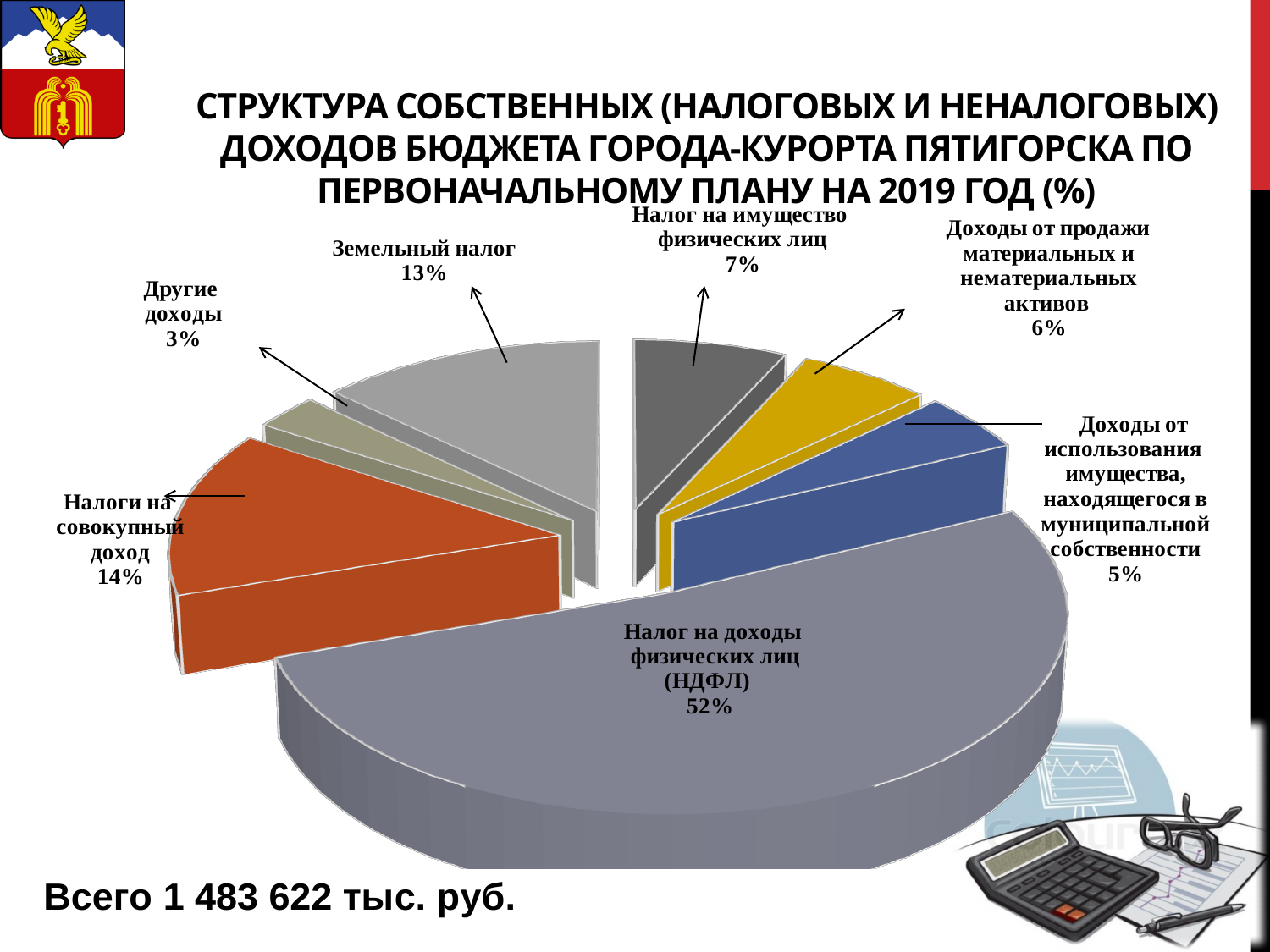
What share of the pie does "Налог на доходы физических лиц (НДФЛ)" represent? 52% Which category has the largest share of the pie? Налог на доходы физических лиц (НДФЛ) What is the value shown for "Налоги на совокупный доход"? 14% How many slices does the pie chart have? 7 What is the difference between the shares of "Налоги на совокупный доход" and "Земельный налог"? 1% What total amount is stated below the chart? 1 483 622 тыс. руб. What is the value shown for "Доходы от использования имущества, находящегося в муниципальной собственности"? 5% Which category has the smallest share of the pie? Другие доходы What year does the chart title refer to? 2019 What kind of chart is shown on the slide? Pie chart Which is larger: "Налог на имущество физических лиц" or "Доходы от продажи материальных и нематериальных активов"? Налог на имущество физических лиц What is the value shown for "Земельный налог"? 13%